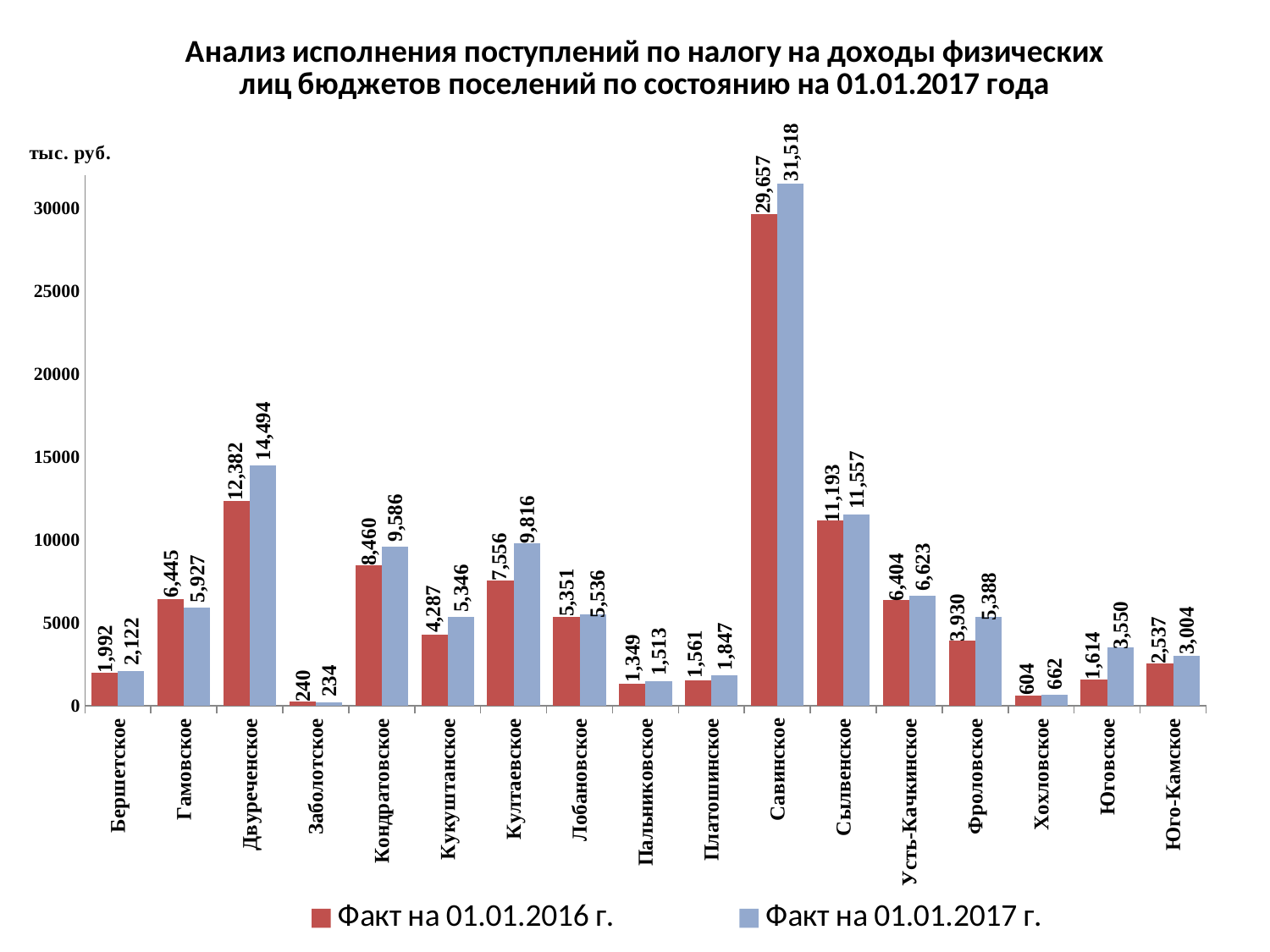
For Гамовское, which is larger: the value for Факт на 01.01.2016 г. or Факт на 01.01.2017 г.? Факт на 01.01.2016 г. What is the difference between the 2017 and 2016 values for Юговское? 1,936 How many categories (settlements) are shown on the x axis? 17 Which category has the lowest value in the series Факт на 01.01.2016 г.? Заболотское What is the difference between the 2017 and 2016 values for Савинское? 1,861 What is the value for Двуреченское in the series Факт на 01.01.2016 г.? 12,382 What is the value for Савинское in the series Факт на 01.01.2017 г.? 31,518 What kind of chart is shown on the slide? bar chart How many series does the legend list? 2 What is the value for Фроловское in the series Факт на 01.01.2017 г.? 5,388 Is the value for Кондратовское in the series Факт на 01.01.2016 г. greater or less than 10000? less Which category has the highest value in the series Факт на 01.01.2017 г.? Савинское